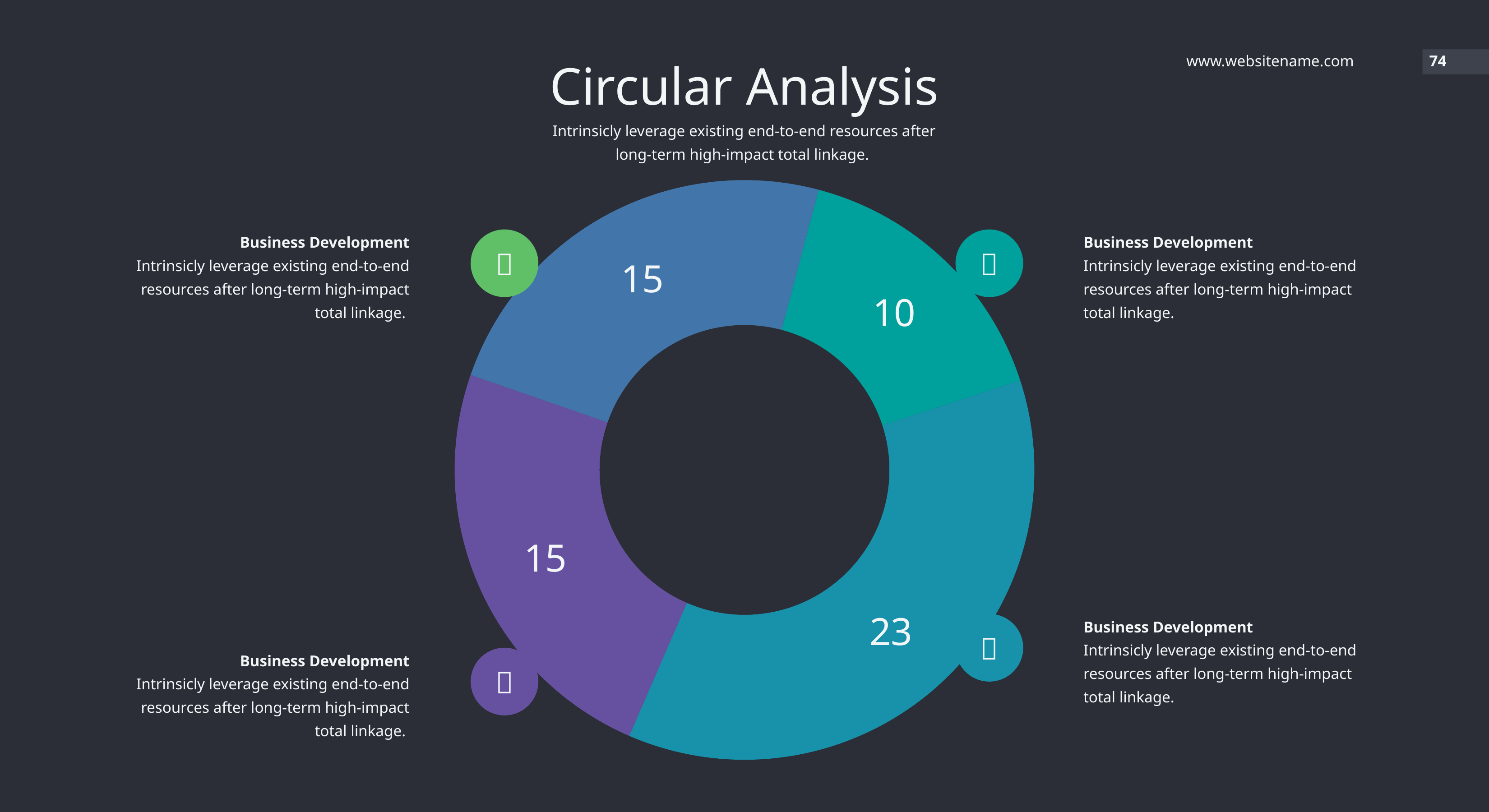
What value is shown on the teal segment at the top right of the doughnut chart? 10 How many segments does the doughnut chart have? 4 What kind of chart is shown on the slide? Doughnut chart What is the value of the smallest segment in the doughnut chart? 10 What value is shown on the purple segment of the doughnut chart? 15 What colour is the segment with the value 23? Cyan (blue-green) What is the value of the largest segment in the doughnut chart? 23 What is the difference between the largest segment value and the smallest segment value in the doughnut chart? 13 Which segment has the larger value, the purple segment or the teal top-right segment? The purple segment What value is shown on the blue segment at the top left of the doughnut chart? 15 What is the total of all the segment values in the doughnut chart? 63 What is the title of the slide containing the doughnut chart? Circular Analysis